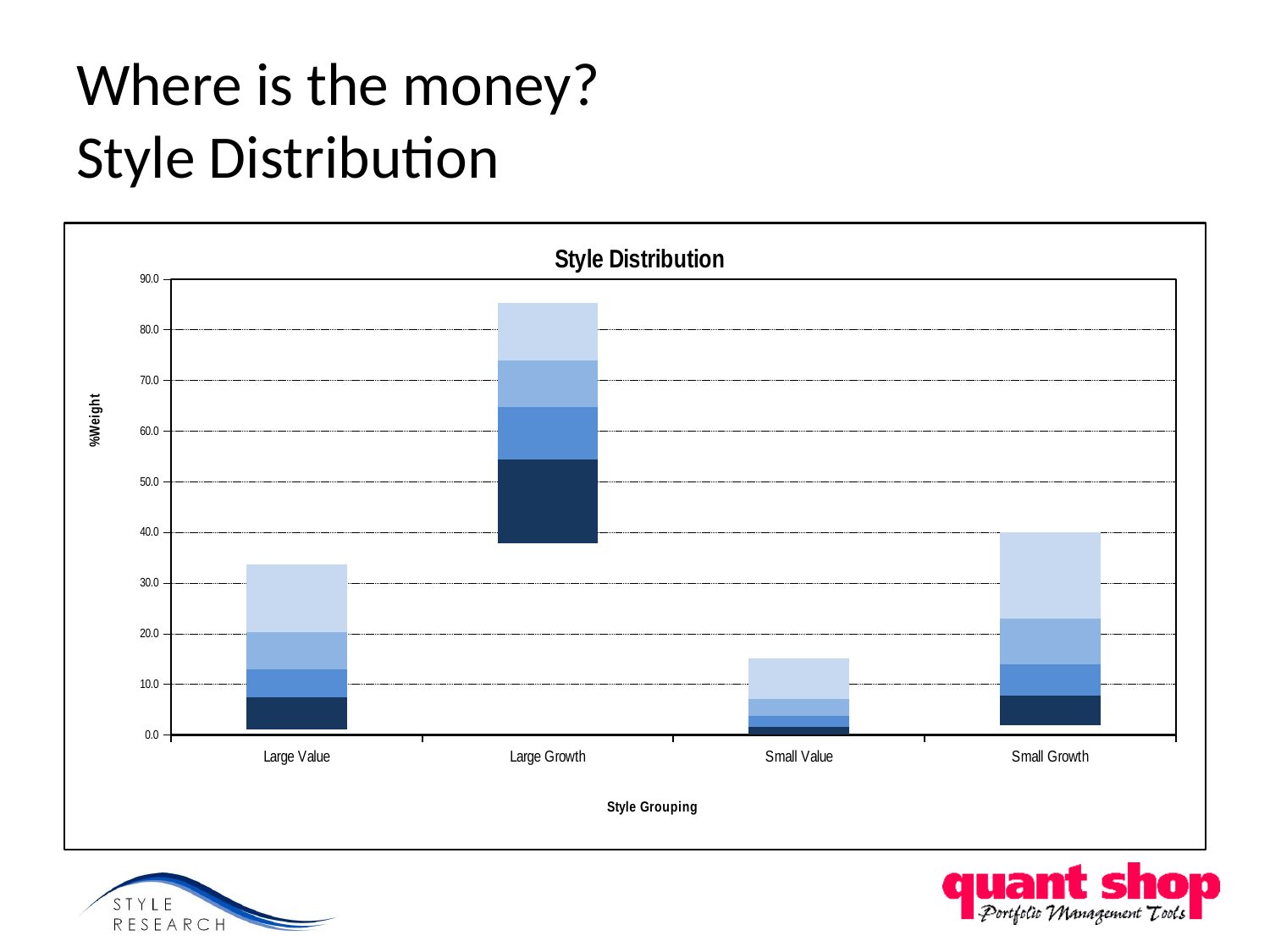
What is the title of the chart? Style Distribution Which bar reaches higher, Small Growth or Large Value? Small Growth Which style grouping has the tallest bar in the chart? Large Growth What is the label on the vertical axis of the chart? %Weight Which style grouping has the shortest bar in the chart? Small Value Which bar reaches higher, Large Growth or Small Value? Large Growth Is the top of the Small Growth bar greater or less than 50.0? less How many style groupings are shown on the x axis of the chart? 4 Is the top of the Large Growth bar greater or less than 80.0? greater Is the top of the Large Value bar greater or less than 30.0? greater What kind of chart is shown on the slide? stacked bar chart